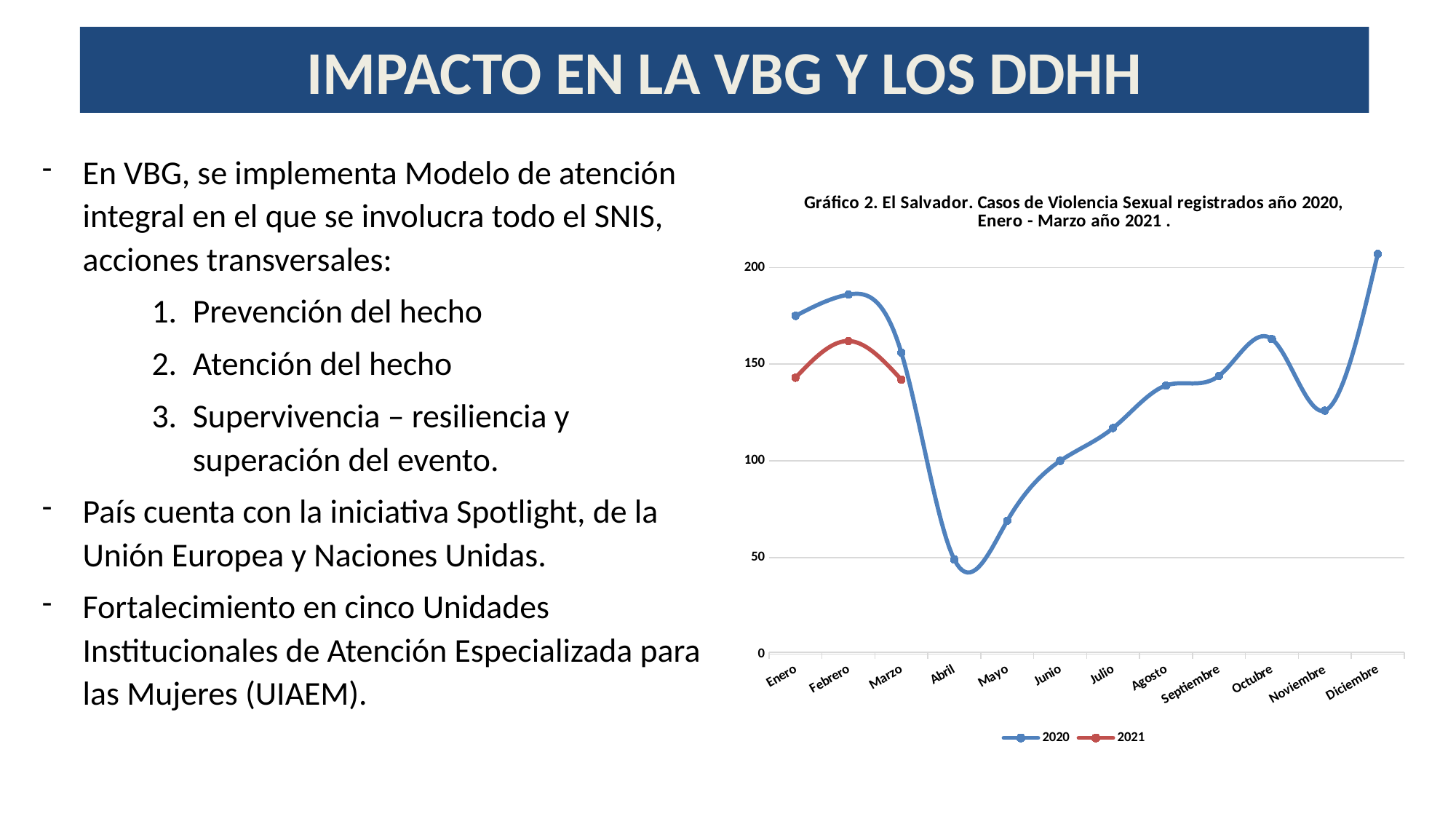
Which colour is used for the 2021 series? red How many series does the legend list? 2 In which month does the 2021 series reach its highest value? Febrero What kind of chart is shown on the slide? line chart Is the 2020 value for Diciembre greater or less than 200? greater Does the 2020 series rise or fall from Marzo to Abril? fall In which month does the 2020 series reach its lowest value? Abril In which month does the 2020 series reach its highest value? Diciembre Is the 2021 value for Febrero greater or less than 150? greater How many months are shown on the x axis? 12 Which is larger, the 2020 value for Febrero or the 2021 value for Febrero? 2020